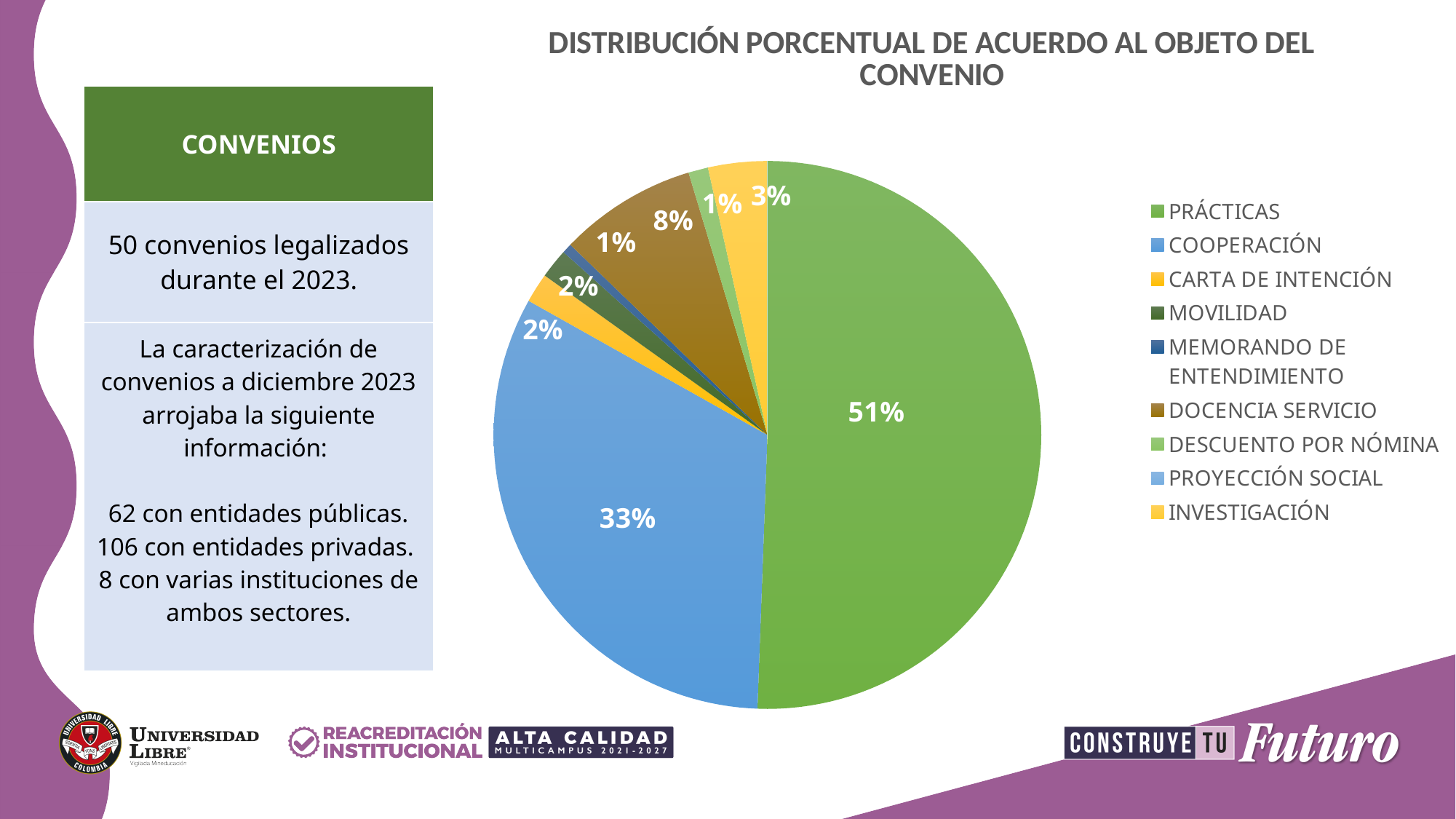
Which category has the largest share of the pie? PRÁCTICAS What percentage of the pie corresponds to DOCENCIA SERVICIO? 8% What type of chart is shown on the slide? pie chart What percentage of the pie corresponds to INVESTIGACIÓN? 3% How many categories does the legend list? 9 Which has a larger share, DOCENCIA SERVICIO or INVESTIGACIÓN? DOCENCIA SERVICIO What is the title of the chart? DISTRIBUCIÓN PORCENTUAL DE ACUERDO AL OBJETO DEL CONVENIO How many percentage points larger is the PRÁCTICAS share than the COOPERACIÓN share? 18 What percentage of the pie corresponds to MOVILIDAD? 2% What percentage of the pie corresponds to PRÁCTICAS? 51% What percentage of the pie corresponds to COOPERACIÓN? 33% What colour is the PRÁCTICAS slice? green